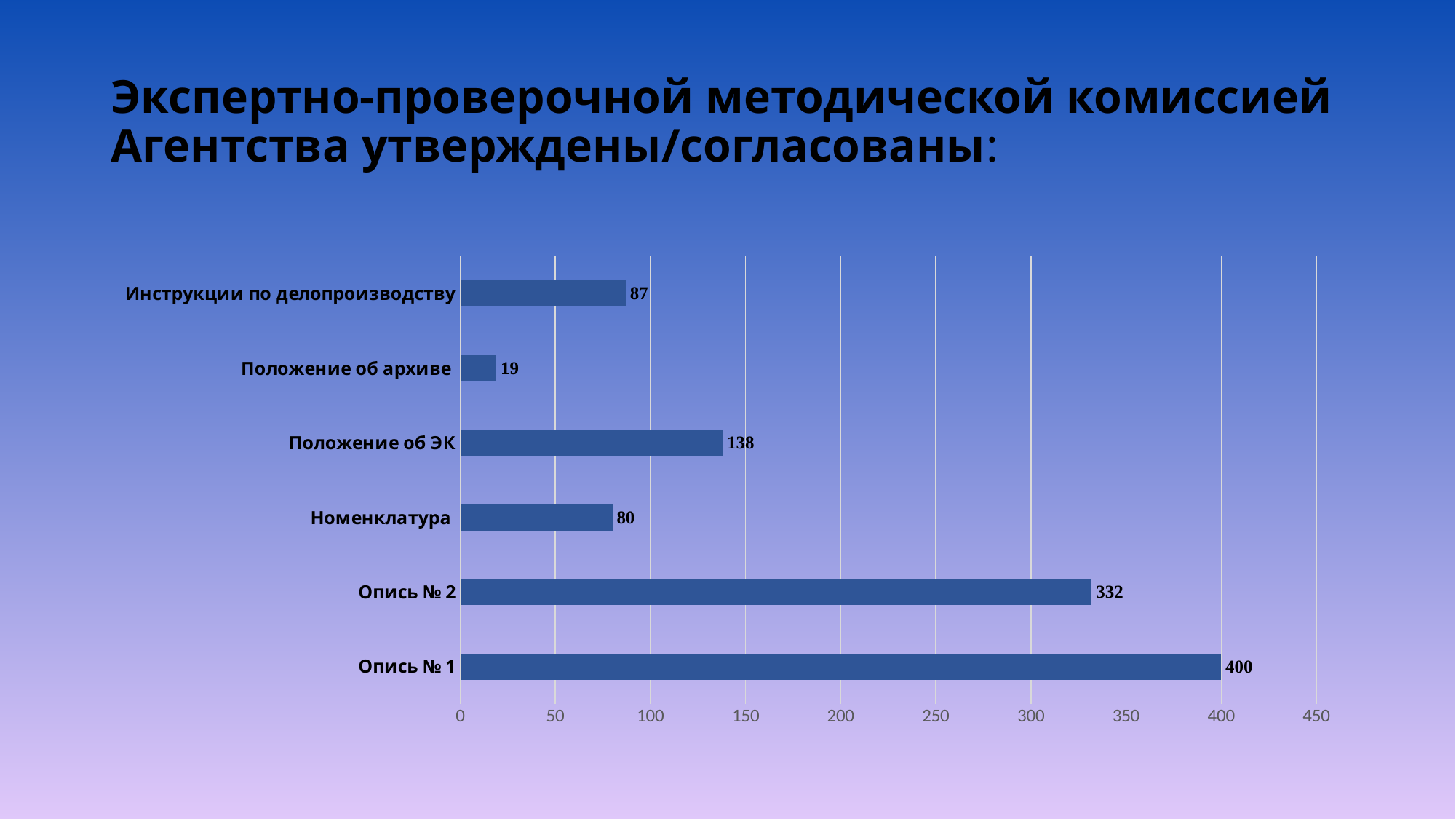
What is the difference between the values for Инструкции по делопроизводству and Номенклатура? 7 What is the value for Положение об архиве? 19 What is the value for Опись № 1? 400 What kind of chart is shown on the slide? Bar chart Which category has the lowest value? Положение об архиве What is the difference between the values for Опись № 1 and Опись № 2? 68 Which category has the highest value? Опись № 1 Is the value for Опись № 2 greater or less than 300? greater How many categories are shown in the chart? 6 Which is larger, the value for Положение об ЭК or the value for Номенклатура? Положение об ЭК What is the value for Инструкции по делопроизводству? 87 What is the value for Положение об ЭК? 138